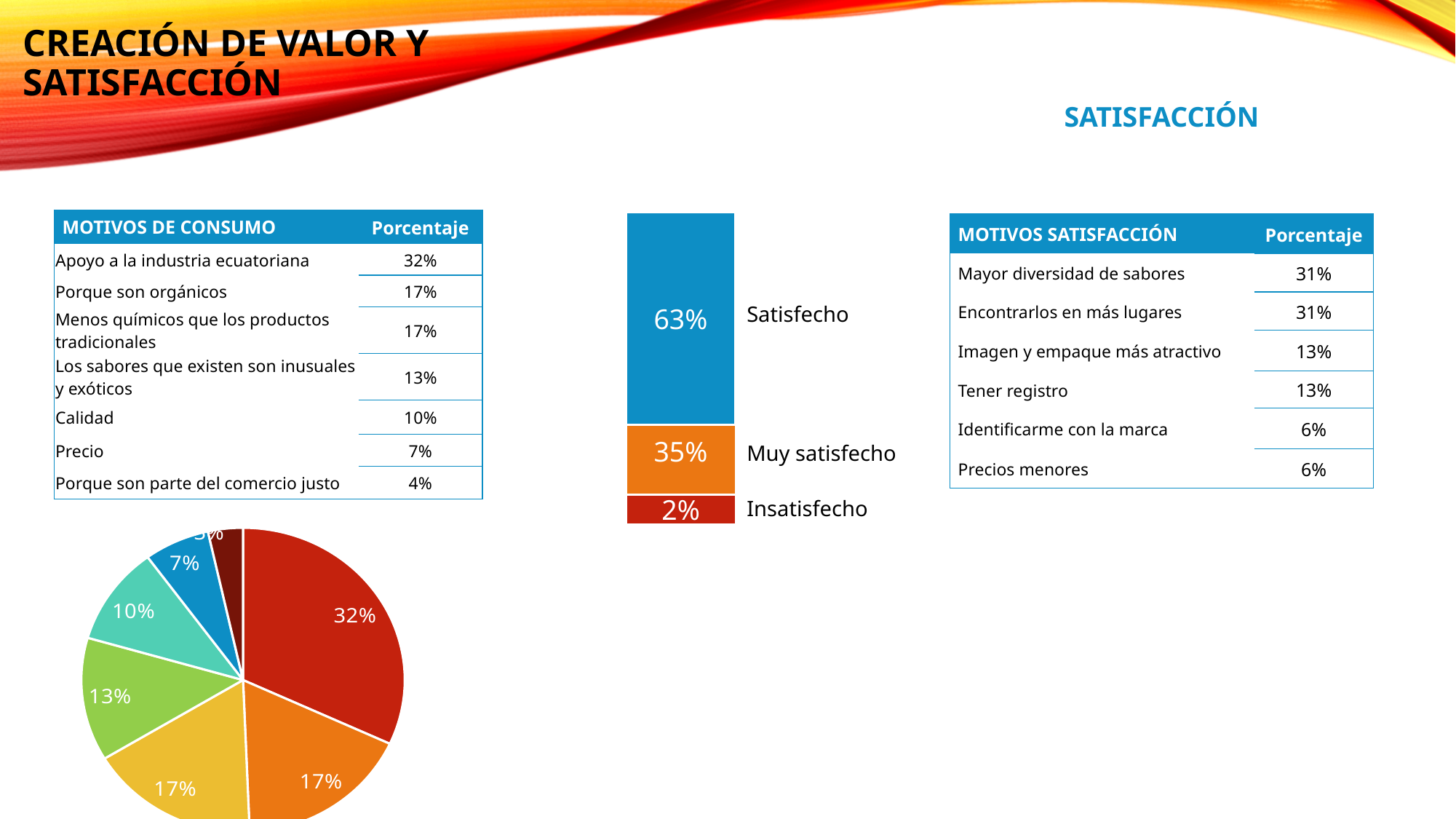
In the stacked bar chart in the middle of the slide, what percentage is labelled Insatisfecho? 2% In the pie chart at the bottom left of the slide, how many slices are there? 7 What kind of chart is shown at the bottom left of the slide? pie chart In the pie chart at the bottom left of the slide, is the slice labelled 32% larger or smaller than the slice labelled 13%? larger In the stacked bar chart in the middle of the slide, what percentage is labelled Muy satisfecho? 35% In the stacked bar chart in the middle of the slide, what is the total of the three segments? 100% In the pie chart at the bottom left of the slide, what is the value of the largest slice? 32% In the stacked bar chart in the middle of the slide, which category has the largest segment? Satisfecho In the stacked bar chart in the middle of the slide, what percentage is labelled Satisfecho? 63% In the stacked bar chart in the middle of the slide, how many segments make up the bar? 3 In the stacked bar chart in the middle of the slide, which category has the smallest segment? Insatisfecho In the stacked bar chart in the middle of the slide, what is the difference in percentage points between Satisfecho and Muy satisfecho? 28